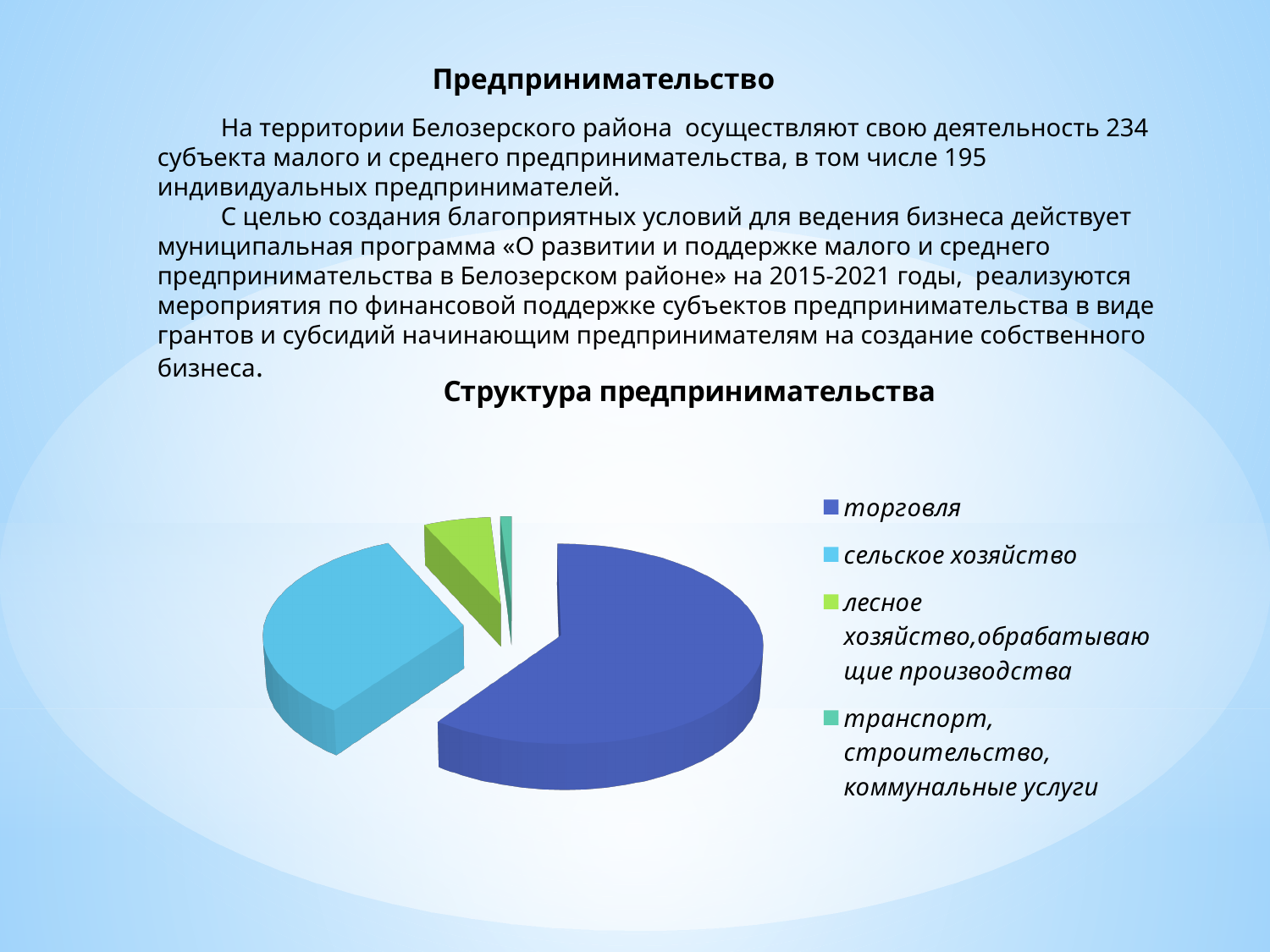
Which category has the second-largest slice of the pie? сельское хозяйство What is the title of the chart on the slide? Структура предпринимательства What kind of chart is shown on the slide? pie chart Which slice is larger: сельское хозяйство or лесное хозяйство,обрабатывающие производства? сельское хозяйство Which slice is larger: лесное хозяйство,обрабатывающие производства or транспорт, строительство, коммунальные услуги? лесное хозяйство,обрабатывающие производства Which category has the smallest slice of the pie? транспорт, строительство, коммунальные услуги Which category has the largest slice of the pie? торговля Which slice is larger: торговля or сельское хозяйство? торговля Which category is shown in dark blue in the pie chart? торговля How many categories does the pie chart show? 4